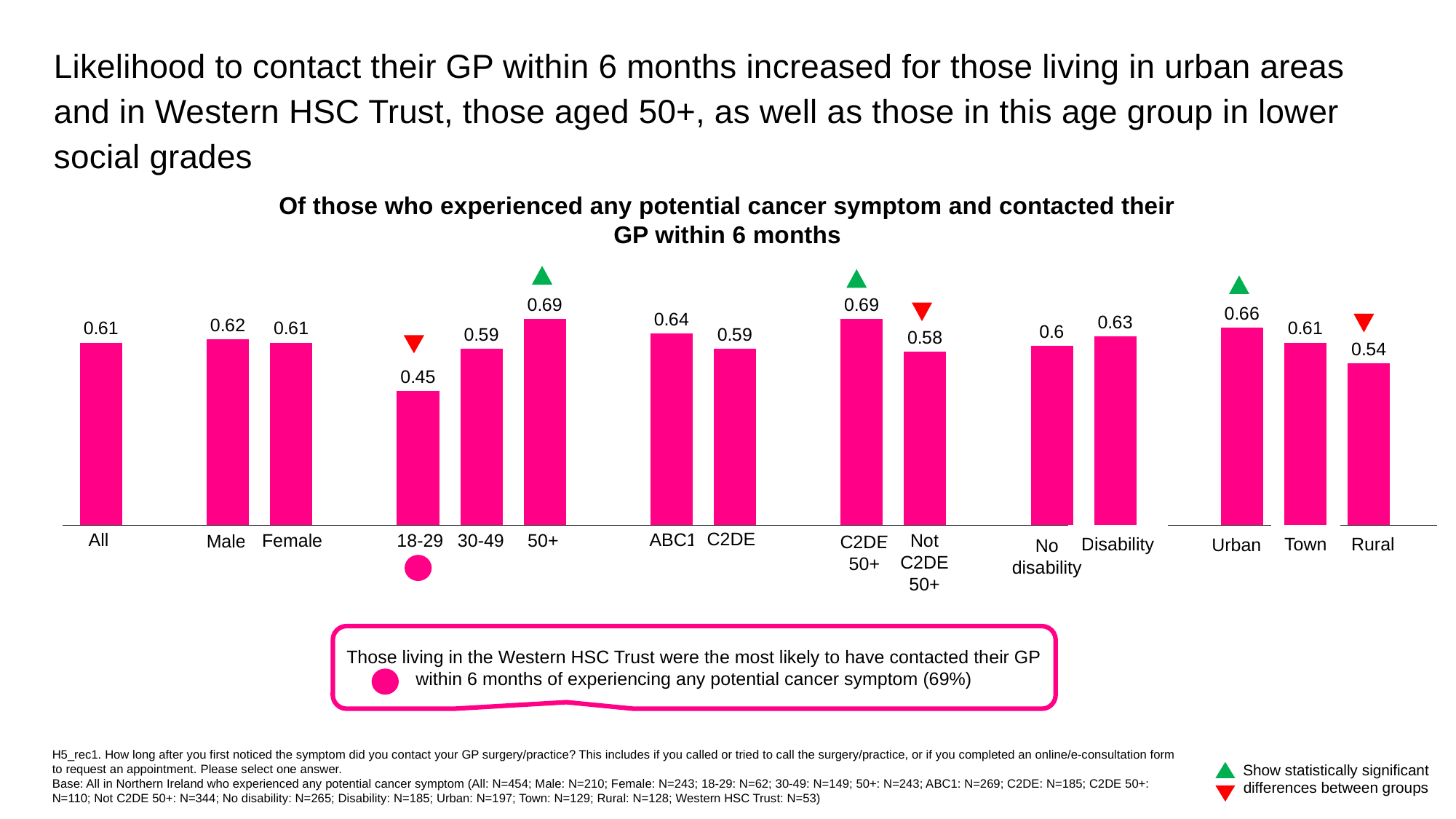
What is the value for Urban? 0.66 How many categories are plotted in the chart? 15 What is the value for Not C2DE 50+? 0.58 What is the value for All? 0.61 What is the difference between the values for Urban and Rural? 0.12 Which category has the lowest value? 18-29 Which has a higher value, ABC1 or C2DE? ABC1 What is the difference between the values for 50+ and 18-29? 0.24 What kind of chart is shown on the slide? Bar chart What is the value for the 18-29 age group? 0.45 What is the value for Disability? 0.63 Which has a higher value, Rural or Town? Town